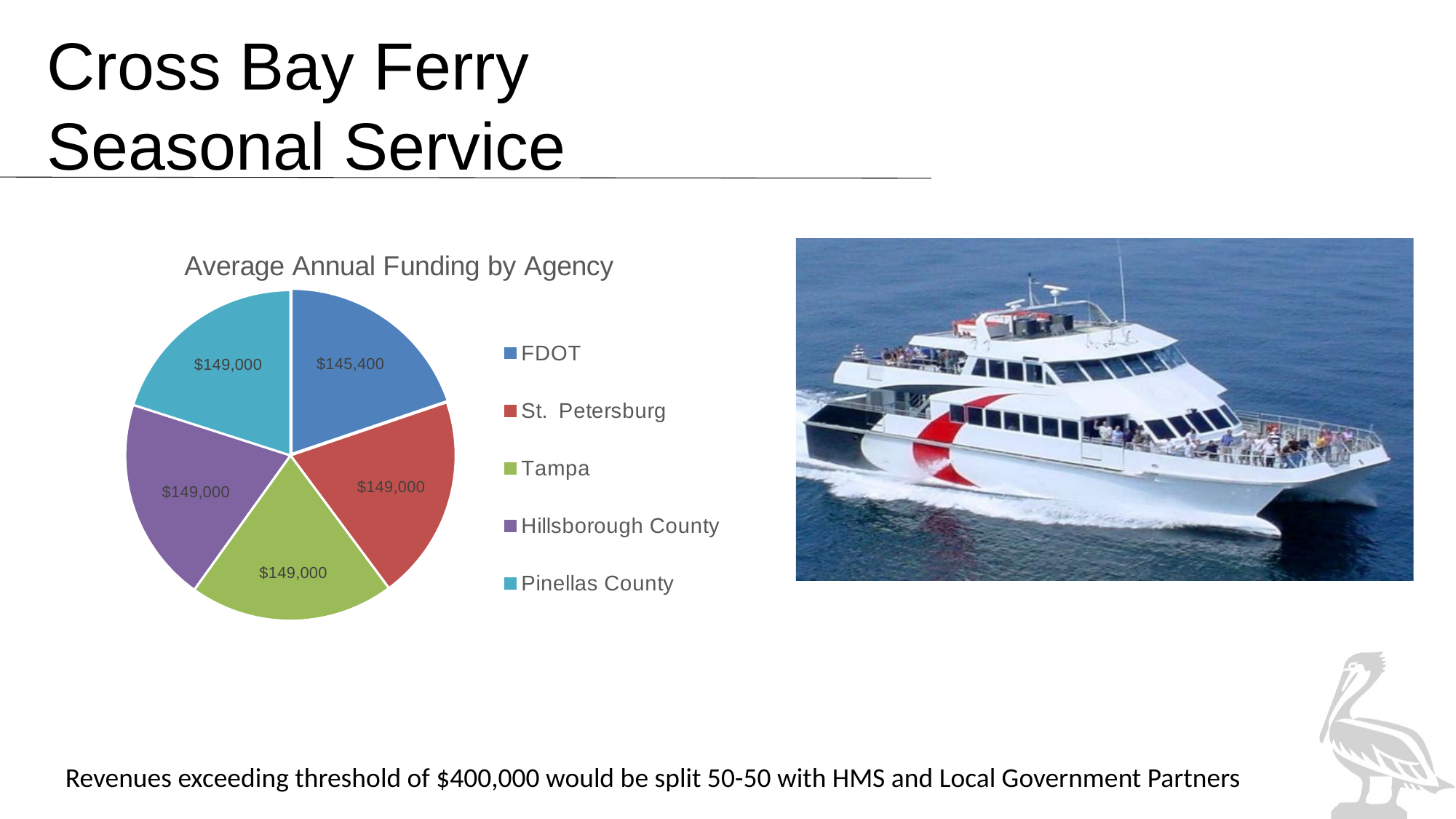
What is the average annual funding from Hillsborough County? $149,000 What kind of chart is used to show Average Annual Funding by Agency? Pie chart What is the difference between the funding from St. Petersburg and the funding from FDOT? $3,600 Which agency contributes the lowest average annual funding? FDOT What is the average annual funding from Pinellas County? $149,000 What is the average annual funding from FDOT? $145,400 Which contributes more average annual funding, FDOT or Tampa? Tampa What is the title of the chart on the slide? Average Annual Funding by Agency What is the total average annual funding across all five agencies? $741,400 What is the average annual funding from Tampa? $149,000 How many entries does the legend of the pie chart list? 5 How many agencies are shown in the pie chart? 5